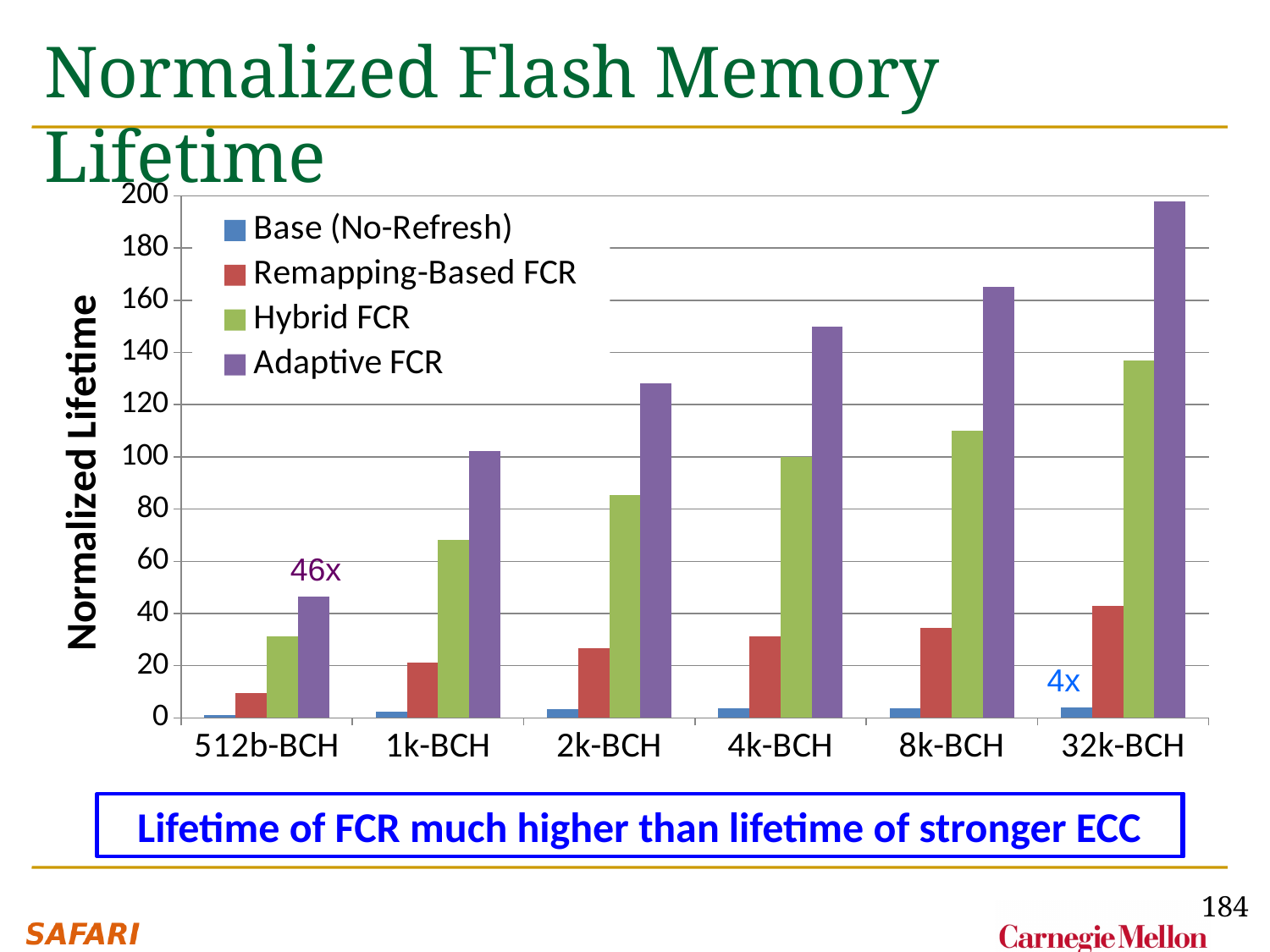
Is the value for Adaptive FCR at 8k-BCH greater or less than 160? greater Which series has the lowest bar in every category? Base (No-Refresh) What kind of chart is shown on the slide? bar chart How many ECC categories are shown along the x axis? 6 How many series does the legend list? 4 Which series has the tallest bar at 32k-BCH? Adaptive FCR What label is printed above the Adaptive FCR bar at 512b-BCH? 46x Is the value for Hybrid FCR at 512b-BCH greater or less than 40? less At 2k-BCH, which is larger: Hybrid FCR or Remapping-Based FCR? Hybrid FCR Is the value for Adaptive FCR at 32k-BCH greater or less than 180? greater Do the Adaptive FCR values rise or fall from 512b-BCH to 32k-BCH? rise What is the title of the y axis? Normalized Lifetime